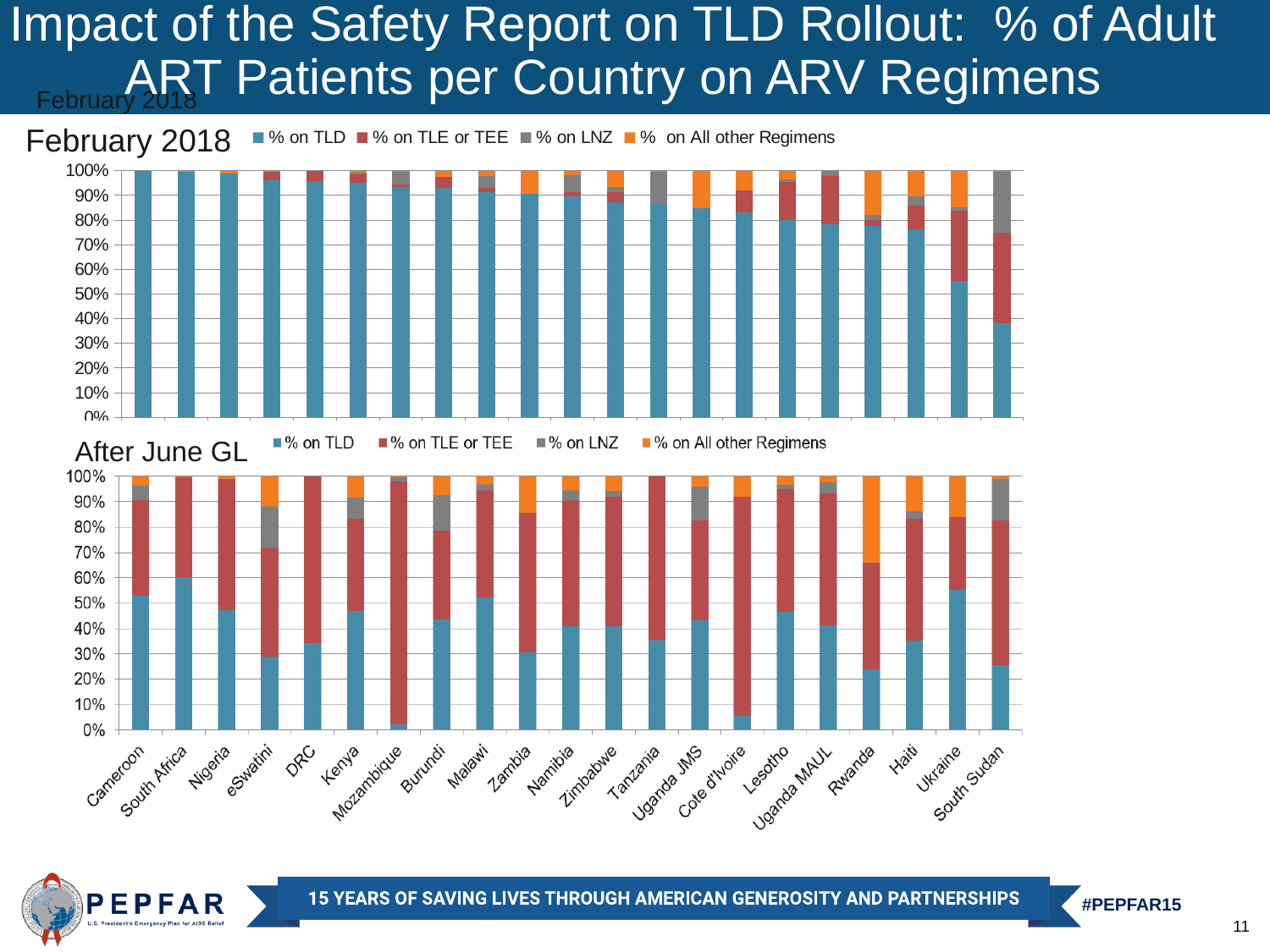
In the "After June GL" chart, which country has the highest % on TLD? South Africa In the "After June GL" chart, which country has a larger % on TLD, South Africa or Rwanda? South Africa How many series does the legend of the "February 2018" chart list? 4 In the "After June GL" chart, is the % on TLD for Mozambique greater or less than 10%? less What kind of chart is the "After June GL" chart? stacked bar chart How many countries are shown on the x axis of the "After June GL" chart? 21 In the "After June GL" chart, is the % on TLD for South Africa greater or less than 50%? greater In the "After June GL" chart, is the % on TLD for Rwanda greater or less than 30%? less In the "February 2018" chart, does the % on TLD generally rise or fall from left to right across the countries? fall Which series is shown in orange in the legend of the "After June GL" chart? % on All other Regimens In the "After June GL" chart, which country has the lowest % on TLD? Mozambique